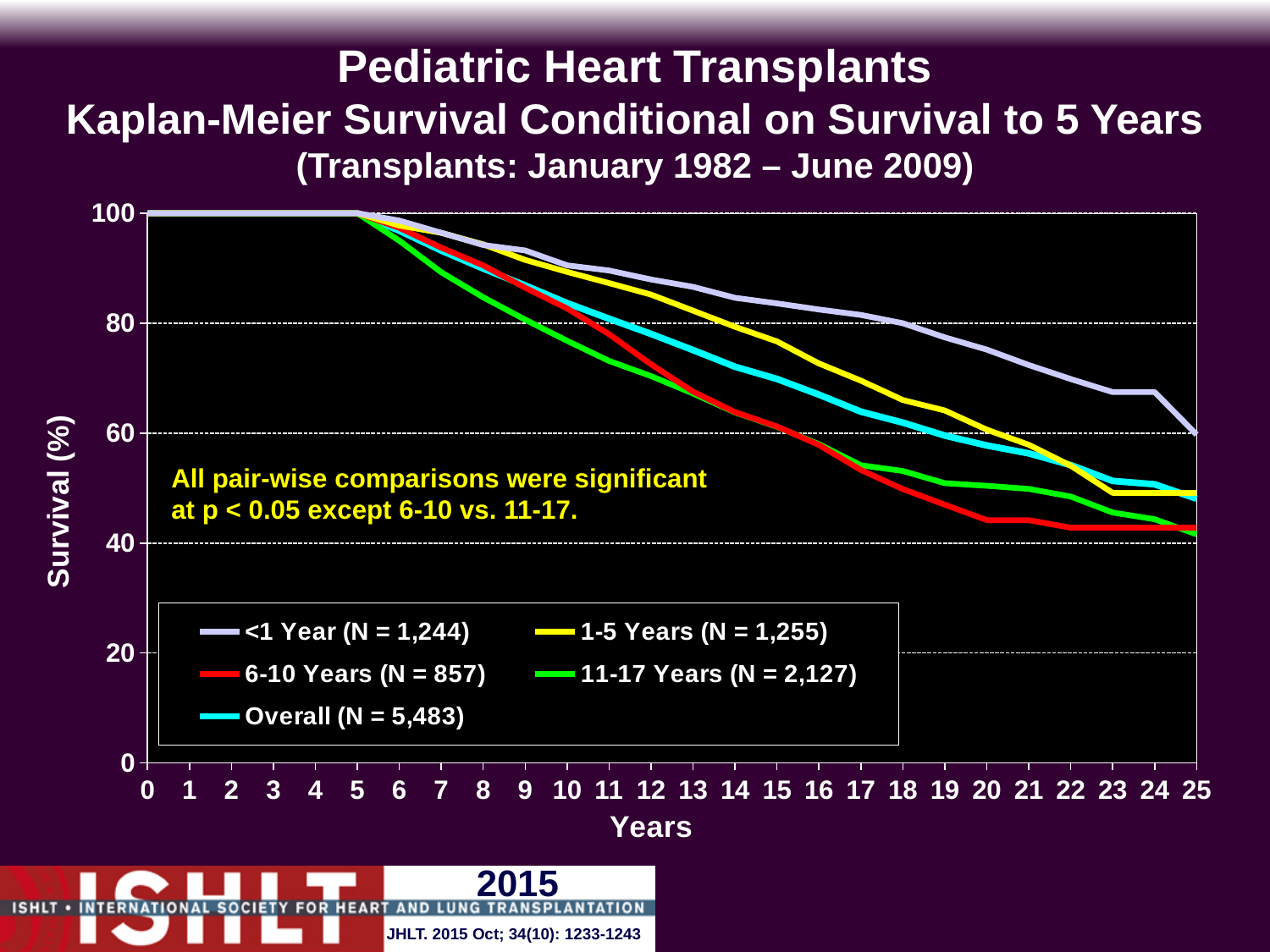
What is the N shown in the legend for the Overall series? 5,483 Is the survival value for the 6-10 Years series at year 25 greater or less than 60? less How many series does the legend list? 5 Which series has the lowest survival at year 20? 6-10 Years (N = 857) At year 15, which is higher: the 1-5 Years series or the Overall series? 1-5 Years What is the survival value for all series at year 5? 100 Is the survival value for the <1 Year series at year 20 greater or less than 60? greater Which series has the highest survival at year 20? <1 Year (N = 1,244) Do the survival curves rise or fall as years increase? fall Is the survival value for the Overall series at year 25 greater or less than 40? greater What kind of chart is shown on the slide? line chart